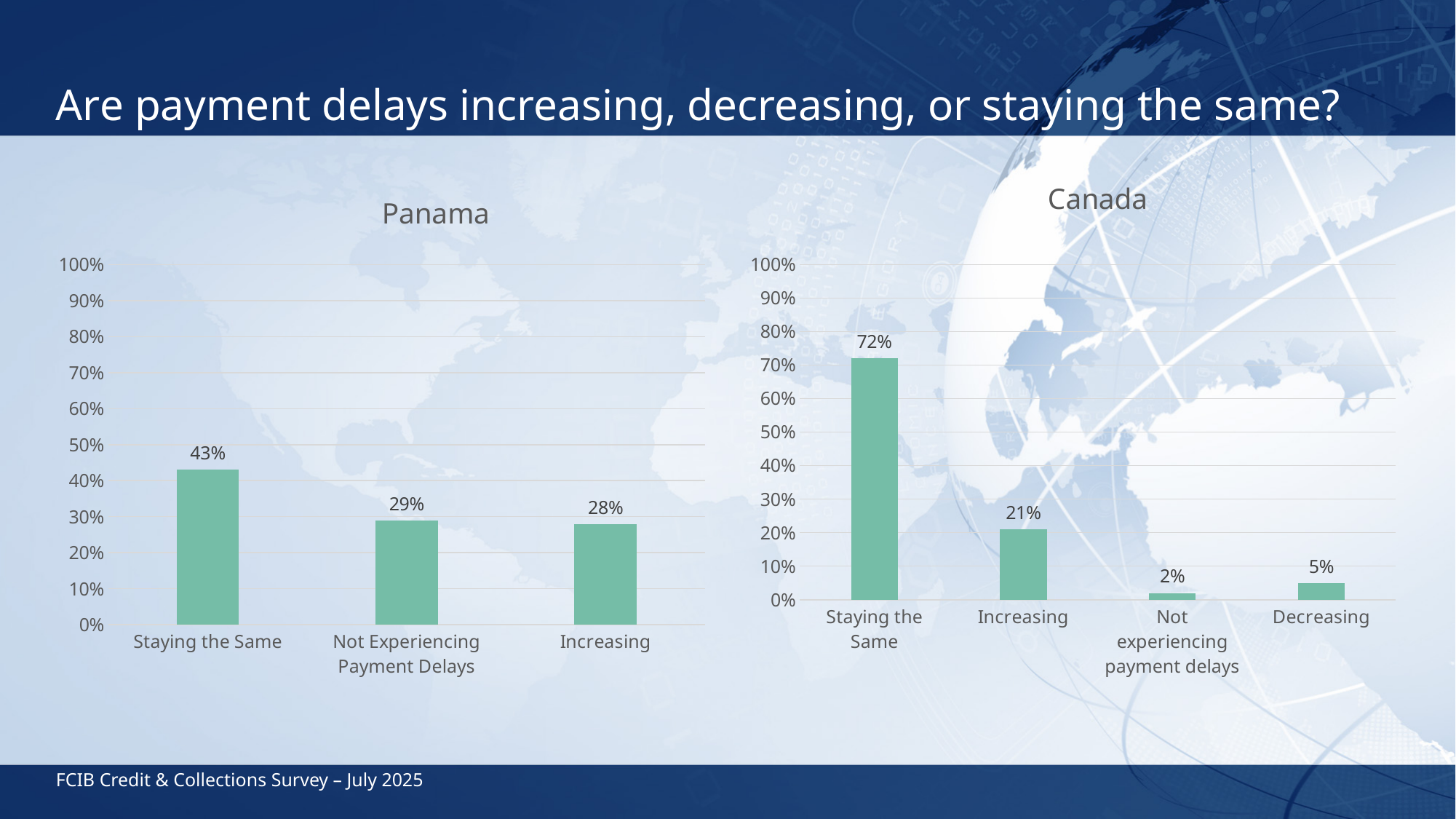
In the Canada chart, what is the value for Staying the Same? 72% How many categories does the Canada chart show? 4 In the Panama chart, which category has the highest value? Staying the Same How many categories does the Panama chart show? 3 In the Panama chart, what is the difference between Staying the Same and Increasing? 15% In the Panama chart, what is the value for Staying the Same? 43% In the Canada chart, which category has the lowest value? Not experiencing payment delays In the Canada chart, what is the value for Decreasing? 5% In the Panama chart, what is the value for Not Experiencing Payment Delays? 29% Which is larger: Increasing in the Panama chart or Increasing in the Canada chart? Panama In the Canada chart, what is the difference between Staying the Same and Increasing? 51% What type of chart is the Panama chart? Bar chart